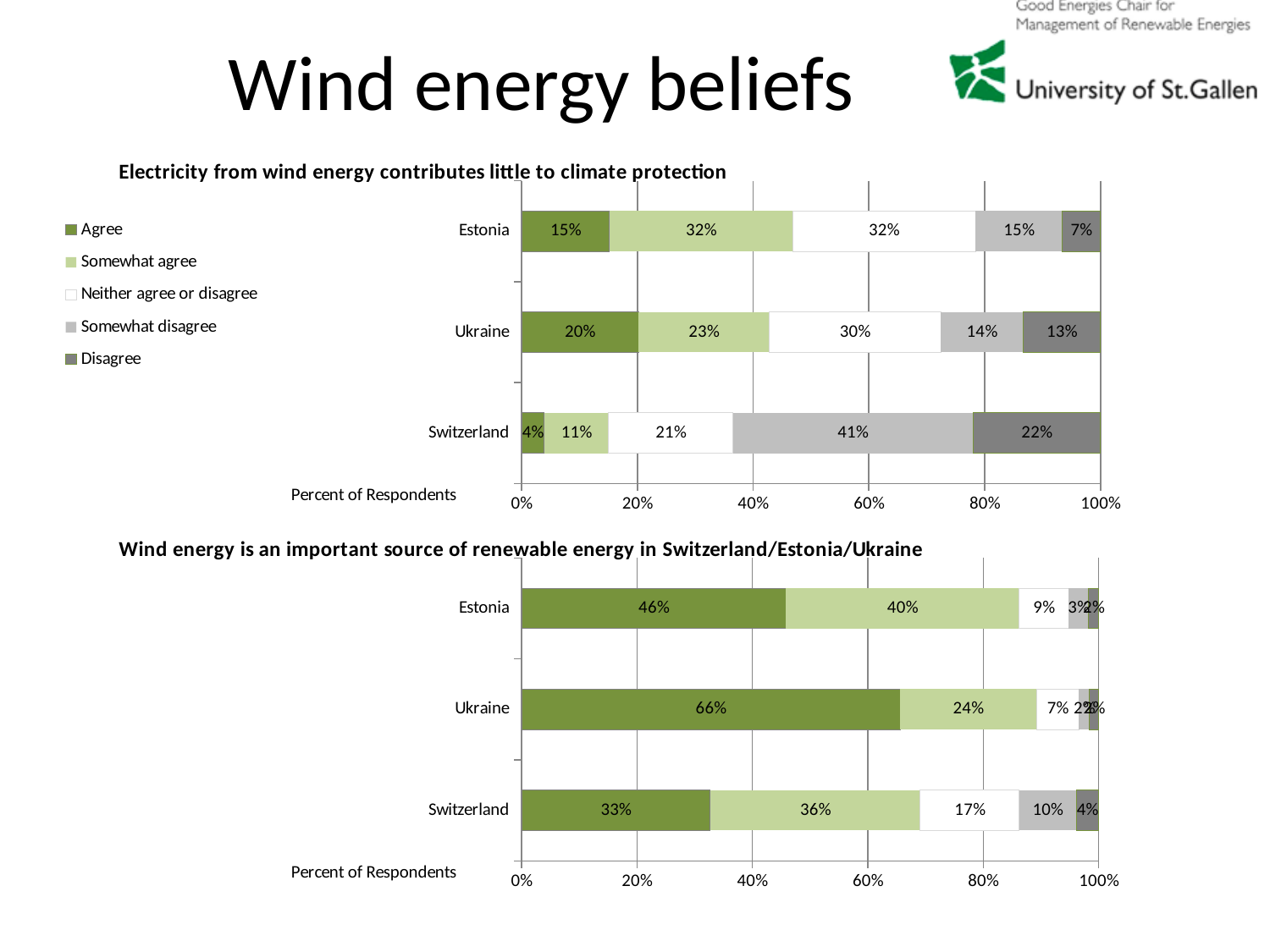
What kind of chart is the chart titled "Electricity from wind energy contributes little to climate protection"? Stacked bar chart In the chart titled "Electricity from wind energy contributes little to climate protection", what percentage of Switzerland respondents chose "Somewhat disagree"? 41% In the chart titled "Electricity from wind energy contributes little to climate protection", which country has the lowest "Agree" share? Switzerland In the chart titled "Wind energy is an important source of renewable energy in Switzerland/Estonia/Ukraine", is the "Agree" share for Estonia larger or smaller than that for Switzerland? larger How many series does the legend on the slide list? 5 In the chart titled "Wind energy is an important source of renewable energy in Switzerland/Estonia/Ukraine", which country has the highest "Agree" share? Ukraine In the chart titled "Electricity from wind energy contributes little to climate protection", what percentage of Ukraine respondents chose "Neither agree or disagree"? 30% In the chart titled "Wind energy is an important source of renewable energy in Switzerland/Estonia/Ukraine", what percentage of Ukraine respondents chose "Agree"? 66% In the chart titled "Wind energy is an important source of renewable energy in Switzerland/Estonia/Ukraine", what is the difference between the "Agree" shares for Ukraine and Switzerland? 33 percentage points In the chart titled "Electricity from wind energy contributes little to climate protection", which country has the highest "Disagree" share? Switzerland In the chart titled "Electricity from wind energy contributes little to climate protection", what is the difference between the "Somewhat agree" shares for Estonia and Ukraine? 9 percentage points In the chart titled "Wind energy is an important source of renewable energy in Switzerland/Estonia/Ukraine", what percentage of Switzerland respondents chose "Somewhat agree"? 36%